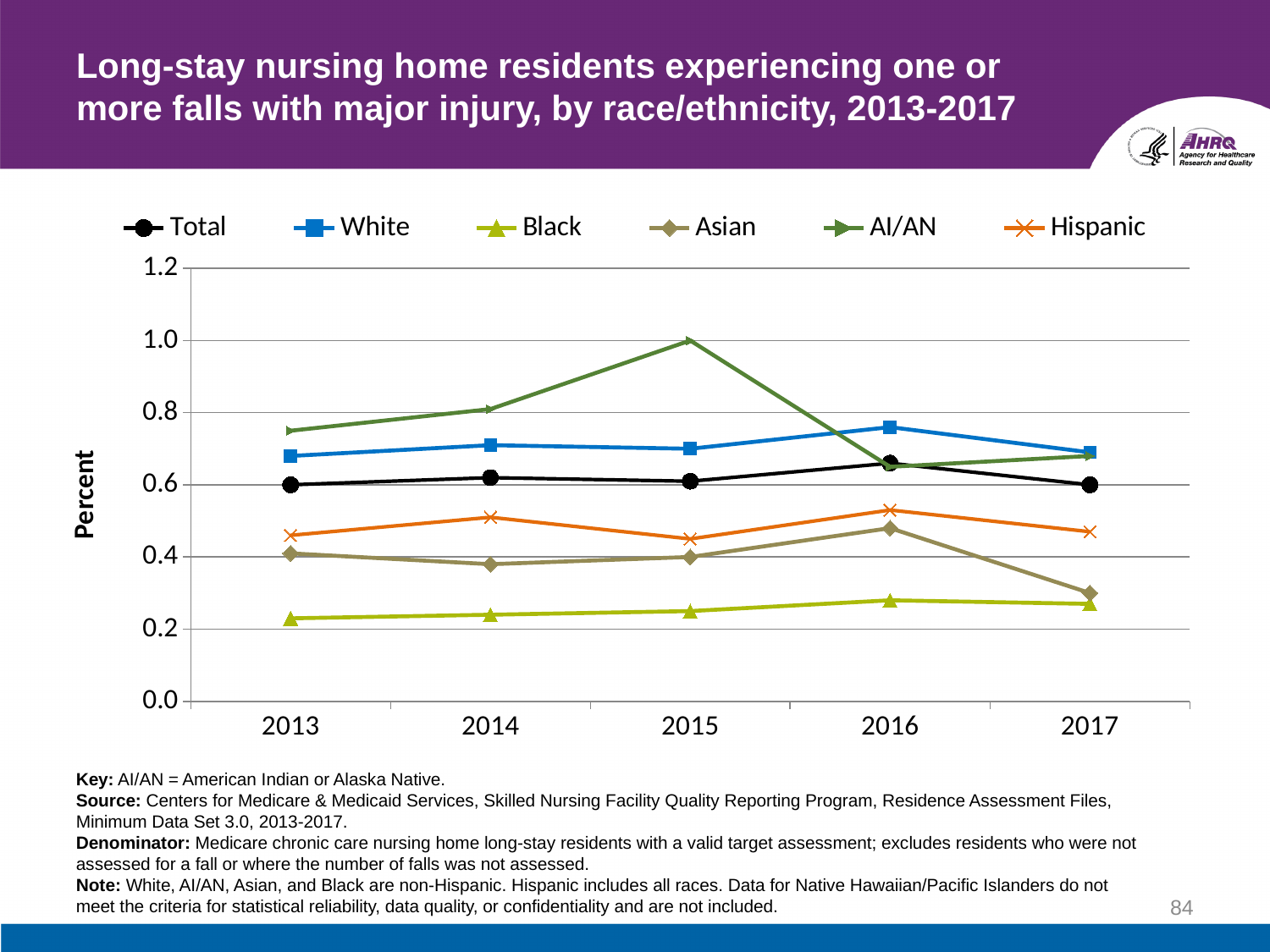
Is the value for White in 2016 greater or less than 0.6? greater Is the value for AI/AN in 2015 greater or less than 0.8? greater How many years are plotted along the x axis? 5 Which race/ethnicity group has the highest value in 2015? AI/AN Does the value for Asian rise or fall from 2016 to 2017? fall Is the value for Asian in 2017 greater or less than 0.4? less What kind of chart is shown on the slide? line chart In 2014, which is larger, the value for White or the value for Hispanic? White Which race/ethnicity group has the lowest value in 2013? Black How many series does the legend list? 6 What is the label on the y axis? Percent